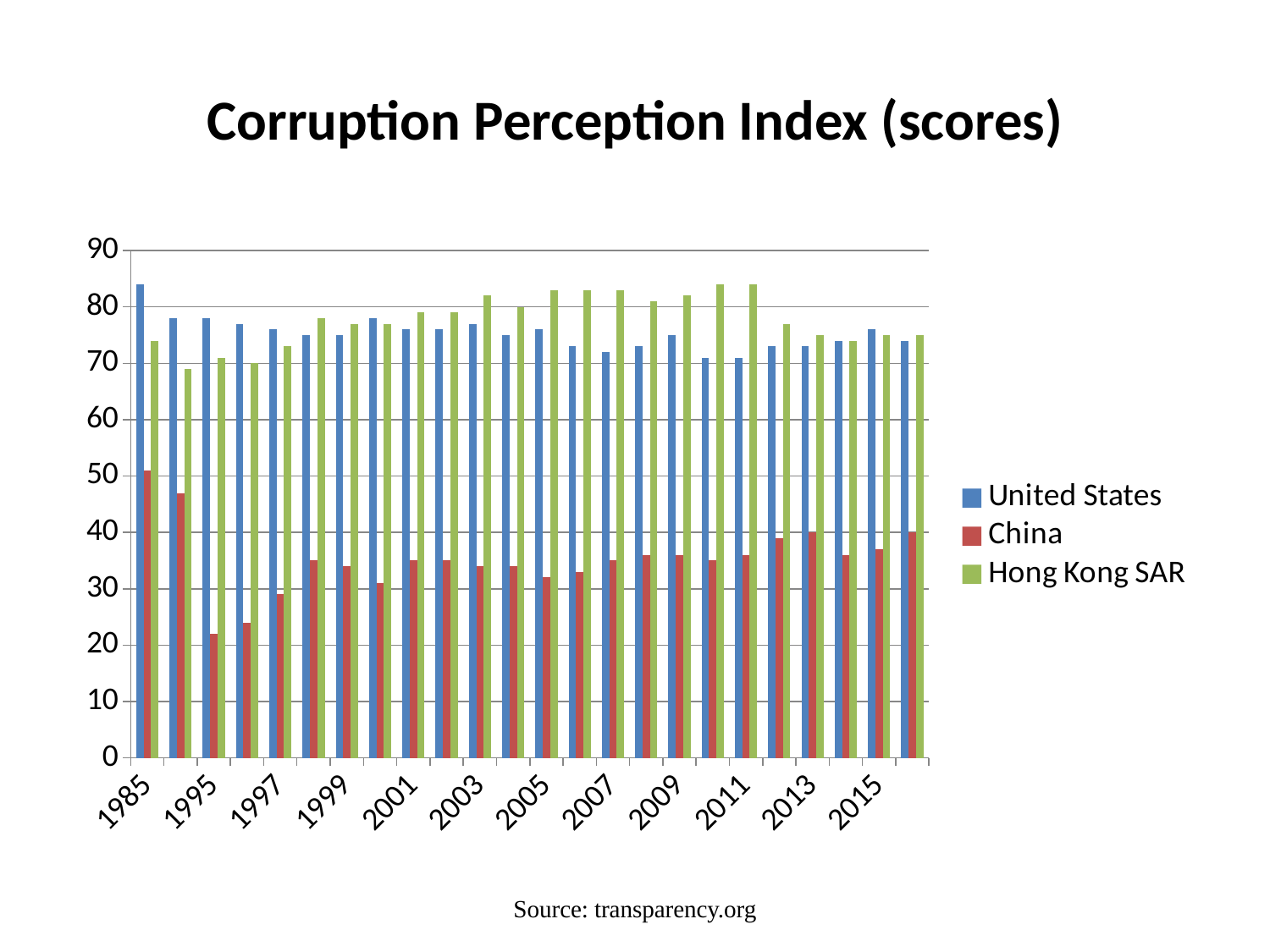
How many series does the legend list? 3 Is the value for China in 1985 greater or less than 40? greater In 1985, which series has the lowest score? China In 2009, which is larger: the value for Hong Kong SAR or the value for United States? Hong Kong SAR What kind of chart is shown on the slide? bar chart What is the title of the chart? Corruption Perception Index (scores) Is the value for United States in 1985 greater or less than 80? greater Is the value for United States in 2011 greater or less than 80? less Which series is shown in green in the legend? Hong Kong SAR In 1985, which series has the highest score? United States